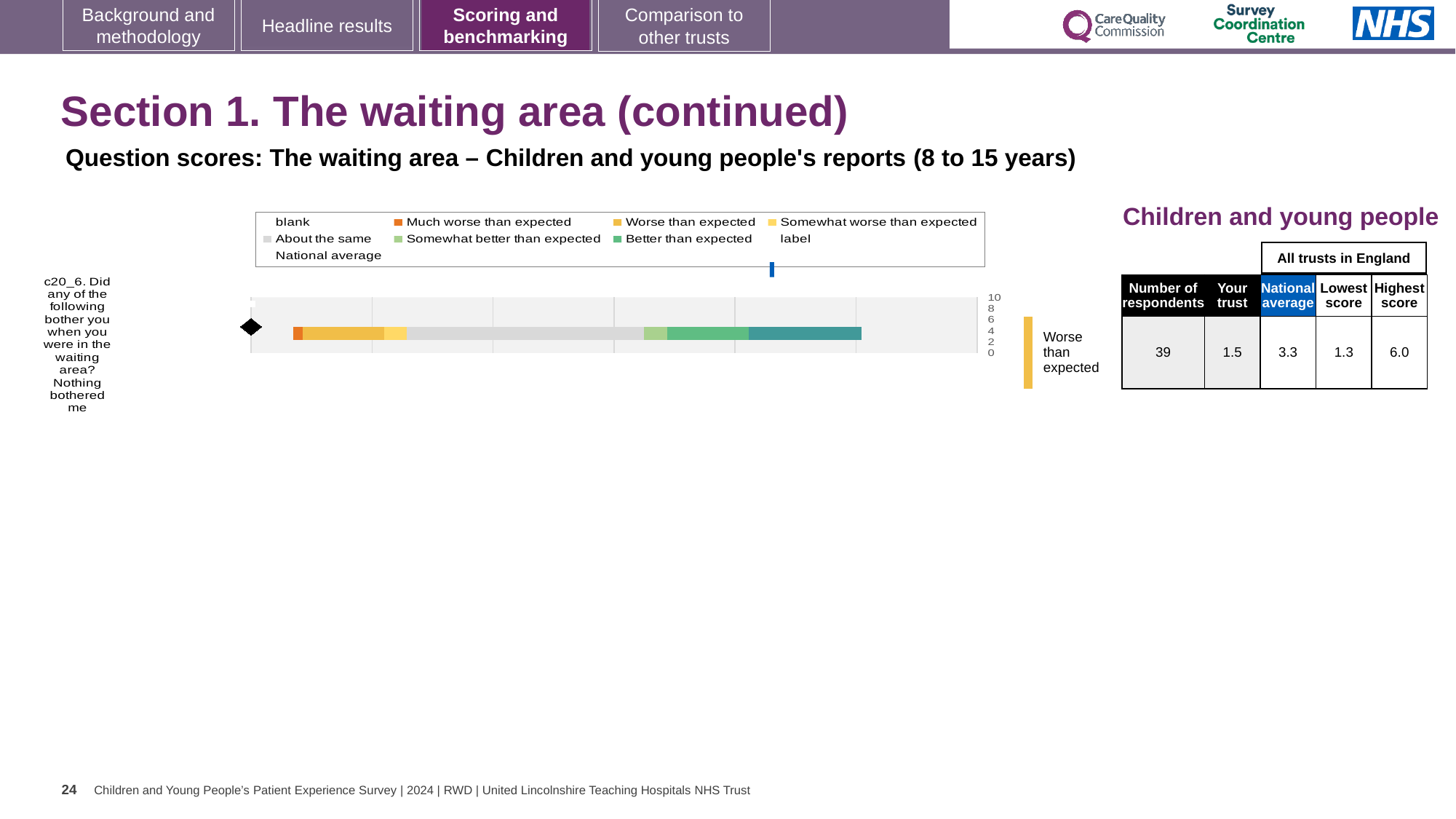
What kind of chart is shown on the slide? bar chart Which question is plotted in the chart? c20_6. Did any of the following bother you when you were in the waiting area? Nothing bothered me What is the highest score among all trusts in England for question c20_6? 6.0 What is the 'Your trust' score for question c20_6 in the table? 1.5 What is the difference between the highest score (6.0) and the lowest score (1.3) for question c20_6? 4.7 What is the difference between the national average (3.3) and the trust's score (1.5) for question c20_6? 1.8 How many respondents answered question c20_6? 39 What is the lowest score among all trusts in England for question c20_6? 1.3 How many questions (categories) are plotted in the chart? 1 What is the national average score for question c20_6? 3.3 Which is larger for question c20_6: the trust's score or the national average? national average How is the trust's result for question c20_6 rated, according to the label next to the chart? Worse than expected